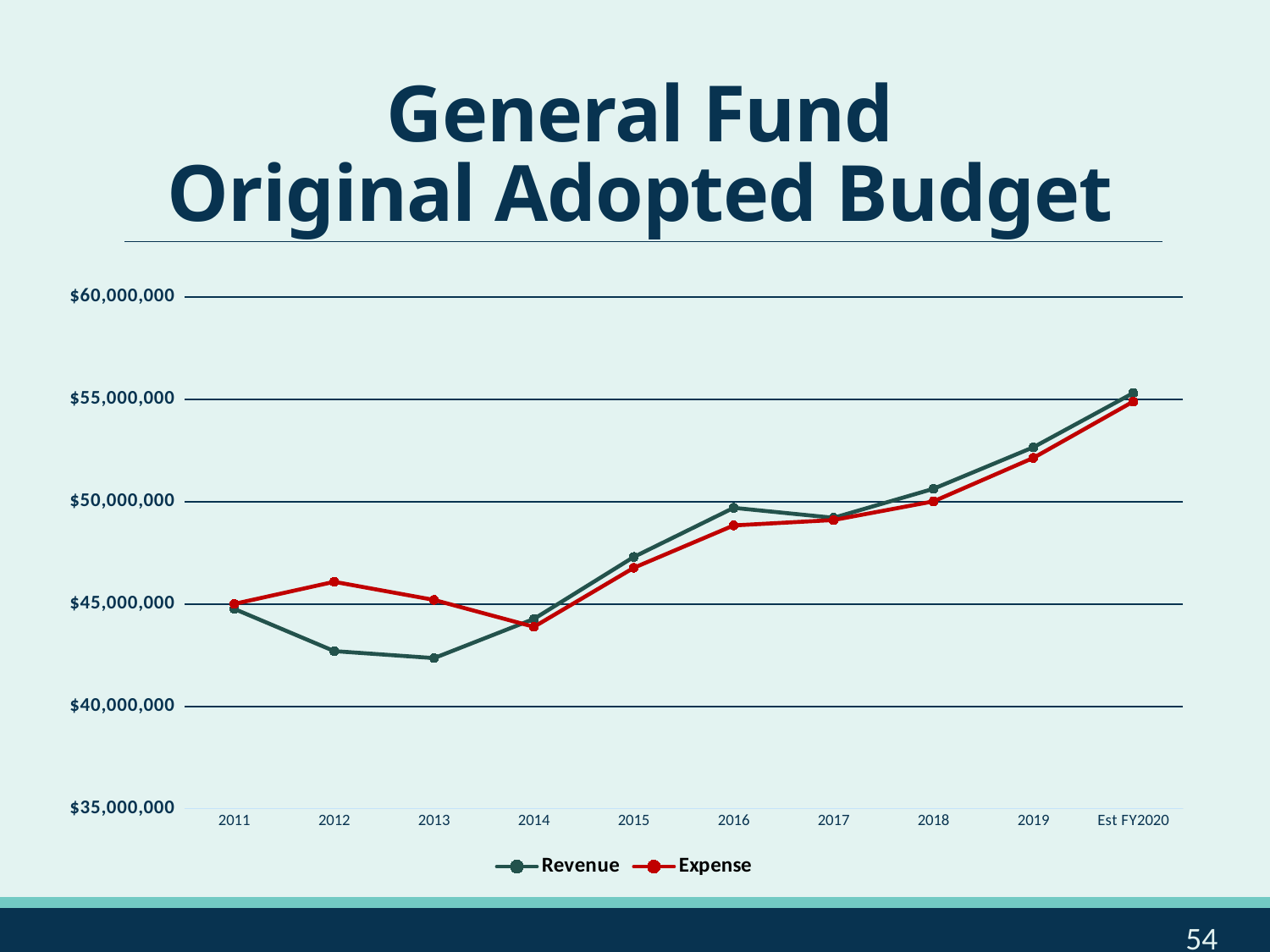
Is the Expense value for 2019 greater or less than $50,000,000? greater Does Revenue rise or fall from 2014 to Est FY2020? rise Is the Expense value for 2012 greater or less than $45,000,000? greater How many series does the legend list? 2 In 2016, which is larger, Revenue or Expense? Revenue Which series does the red line represent? Expense Is the Expense value for 2014 greater or less than $45,000,000? less In 2012, which is larger, Revenue or Expense? Expense How many years are plotted along the x axis? 10 What kind of chart is shown on the slide? line chart In which year is Expense at its highest? Est FY2020